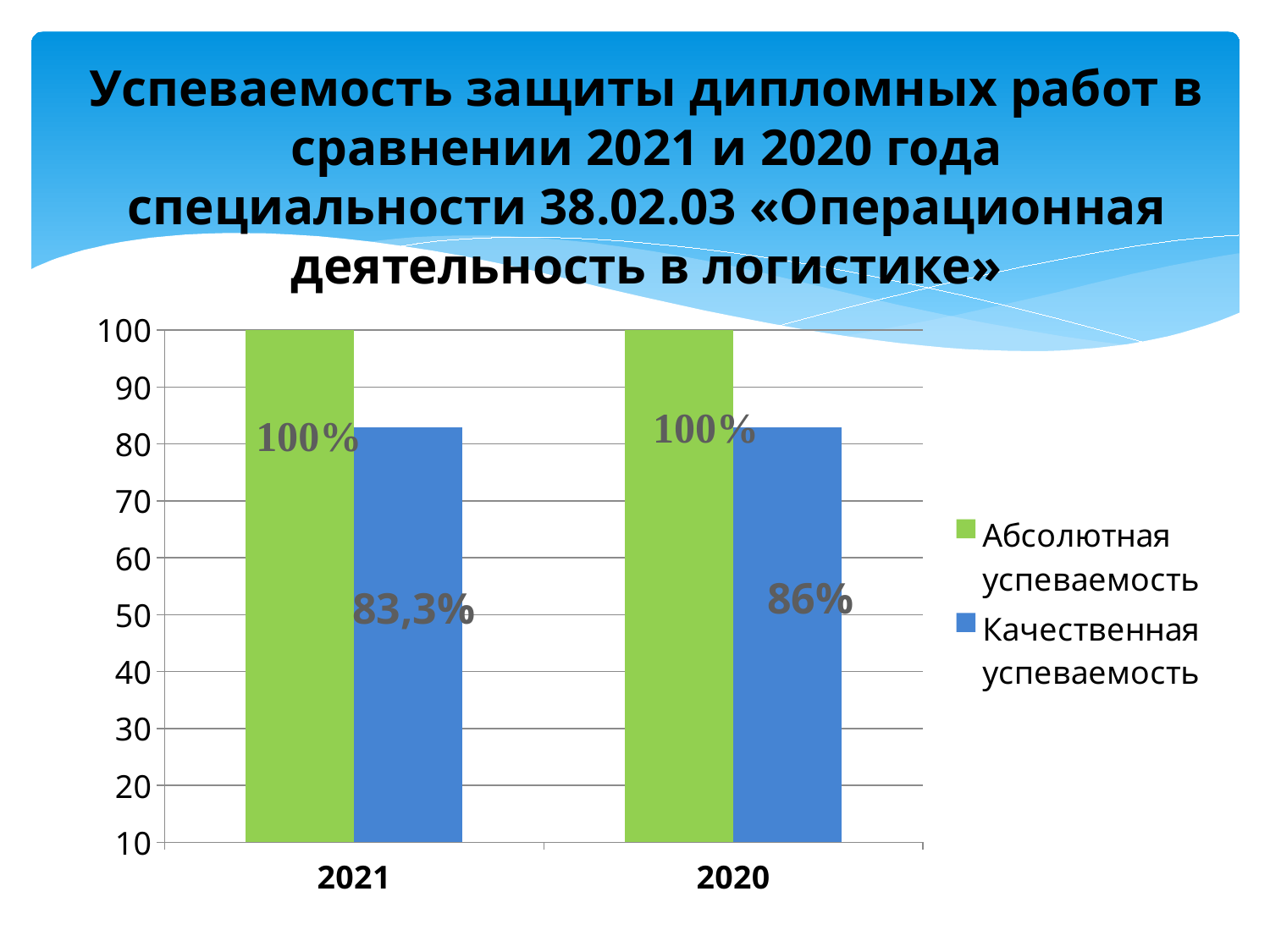
How many categories are shown on the x axis? 2 What is the value of Качественная успеваемость for 2020? 86% Which series is shown in blue in the legend? Качественная успеваемость Which series is shown in green in the legend? Абсолютная успеваемость What kind of chart is shown on the slide? bar chart What is the value of Абсолютная успеваемость for 2021? 100% What is the value of Абсолютная успеваемость for 2020? 100% How many series does the legend list? 2 What is the difference between the Качественная успеваемость values for 2020 and 2021? 2,7% What is the value of Качественная успеваемость for 2021? 83,3% Which year has the lower value for Качественная успеваемость according to the data labels? 2021 Is the value for Качественная успеваемость in 2021 greater or less than 90? less